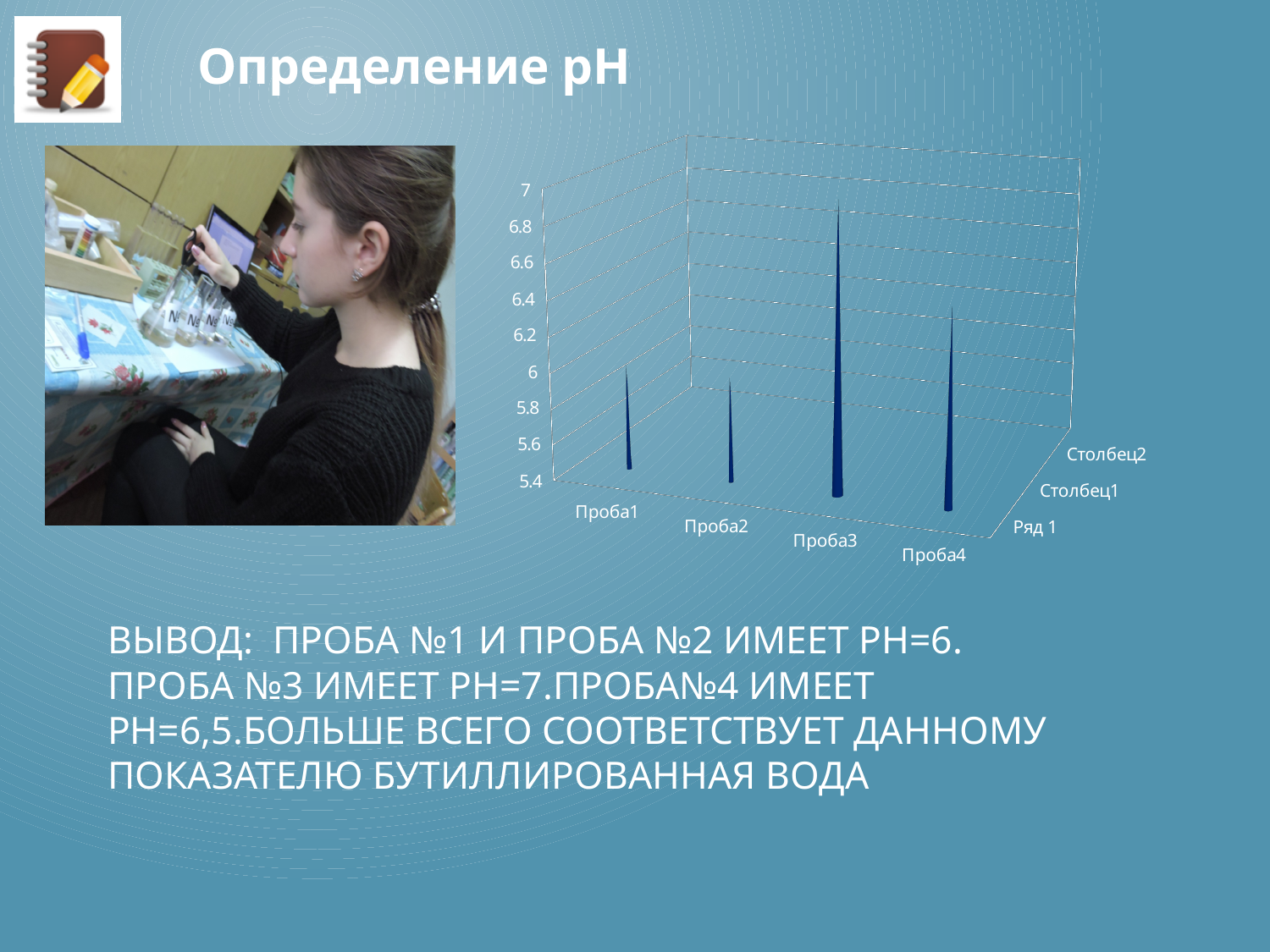
Is the value for Проба2 greater or less than 6.4? less What is the highest value shown on the chart's vertical axis? 7 Is the value for Проба1 greater or less than 6.4? less Is the value for Проба3 greater or less than 6.6? greater Which is larger on the chart, the value for Проба3 or the value for Проба4? Проба3 What is the lowest value shown on the chart's vertical axis? 5.4 Which is larger on the chart, the value for Проба4 or the value for Проба1? Проба4 How many samples (categories) are plotted on the chart? 4 Which sample has the highest value on the chart? Проба3 What kind of chart is shown on the slide? bar chart